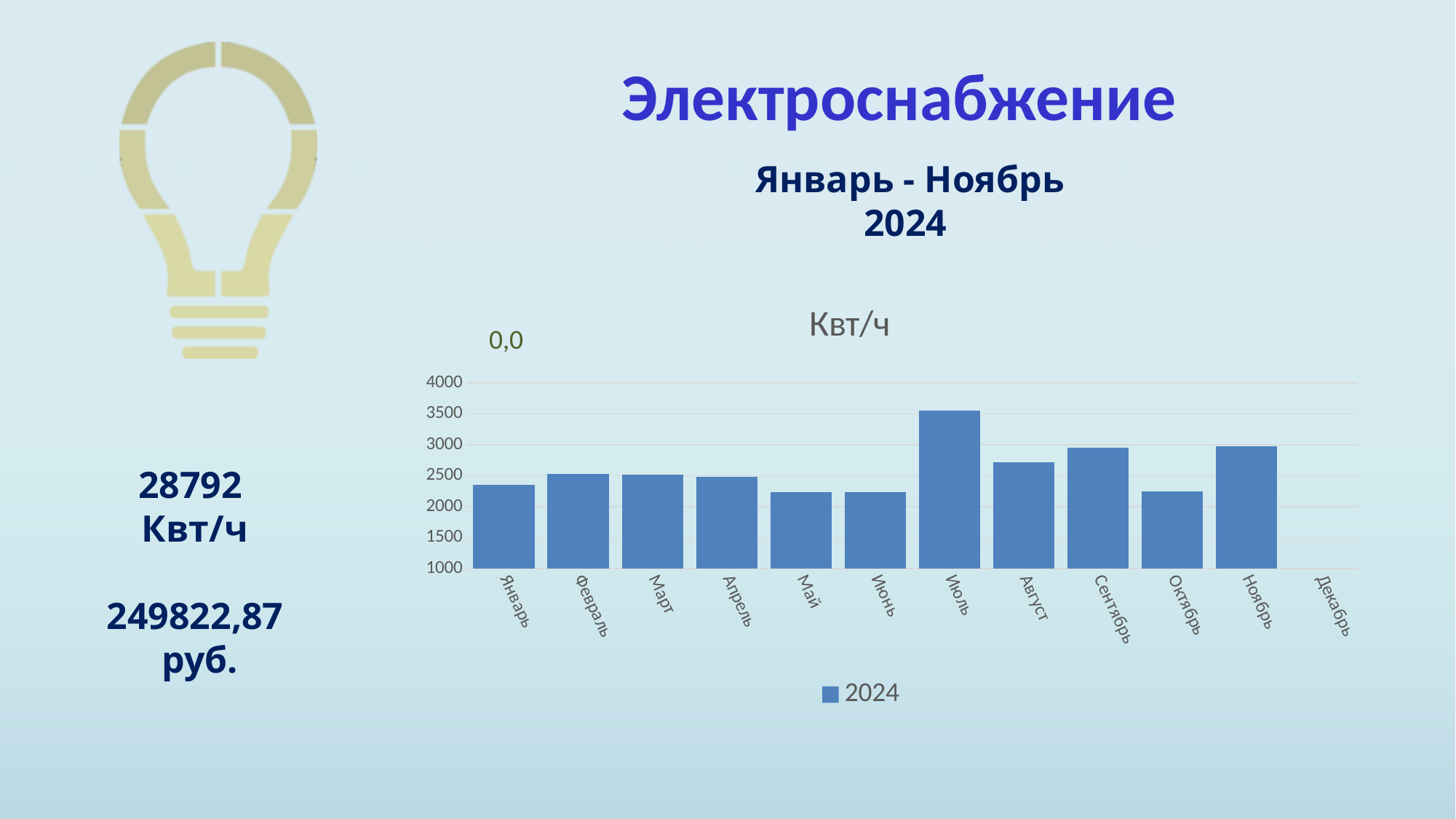
Is the value for Июль greater or less than 3000? greater What series name is shown in the chart legend? 2024 How many month categories are labelled on the x axis of the chart? 12 Is the value for Май greater or less than 2500? less Which month has the highest bar in the chart? Июль Is the value for Август greater or less than 2500? greater How many series does the chart legend list? 1 Which is larger, the value for Август or the value for Октябрь? Август What is the title of the chart? Квт/ч Which is larger, the value for Июль or the value for Август? Июль What kind of chart is shown on the slide? bar chart